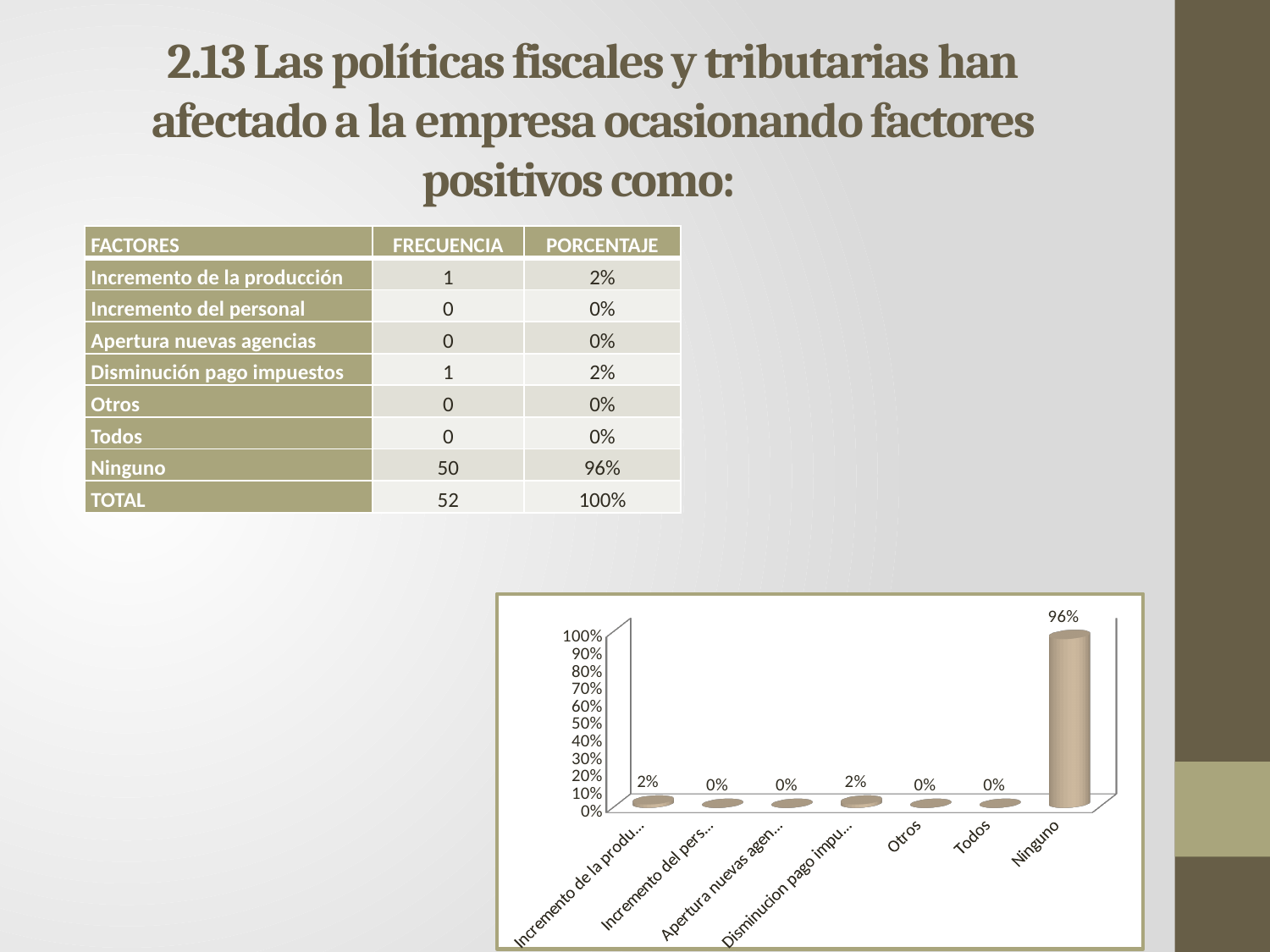
In the chart, what is the value for Otros? 0% In the chart, what is the value for Incremento de la producción? 2% Which category has the highest value in the chart? Ninguno Is the value for Ninguno in the chart greater or less than 50%? greater What kind of chart is shown on the slide? bar chart In the chart, what is the value for Disminución pago impuestos? 2% In the chart, what is the value for Todos? 0% In the chart, what is the value for Ninguno? 96% Which is larger in the chart, the value for Ninguno or the value for Otros? Ninguno What is the highest value shown on the vertical axis of the chart? 100% How many categories are shown on the x axis of the chart? 7 What is the difference between the values for Ninguno and Incremento de la producción in the chart? 94%